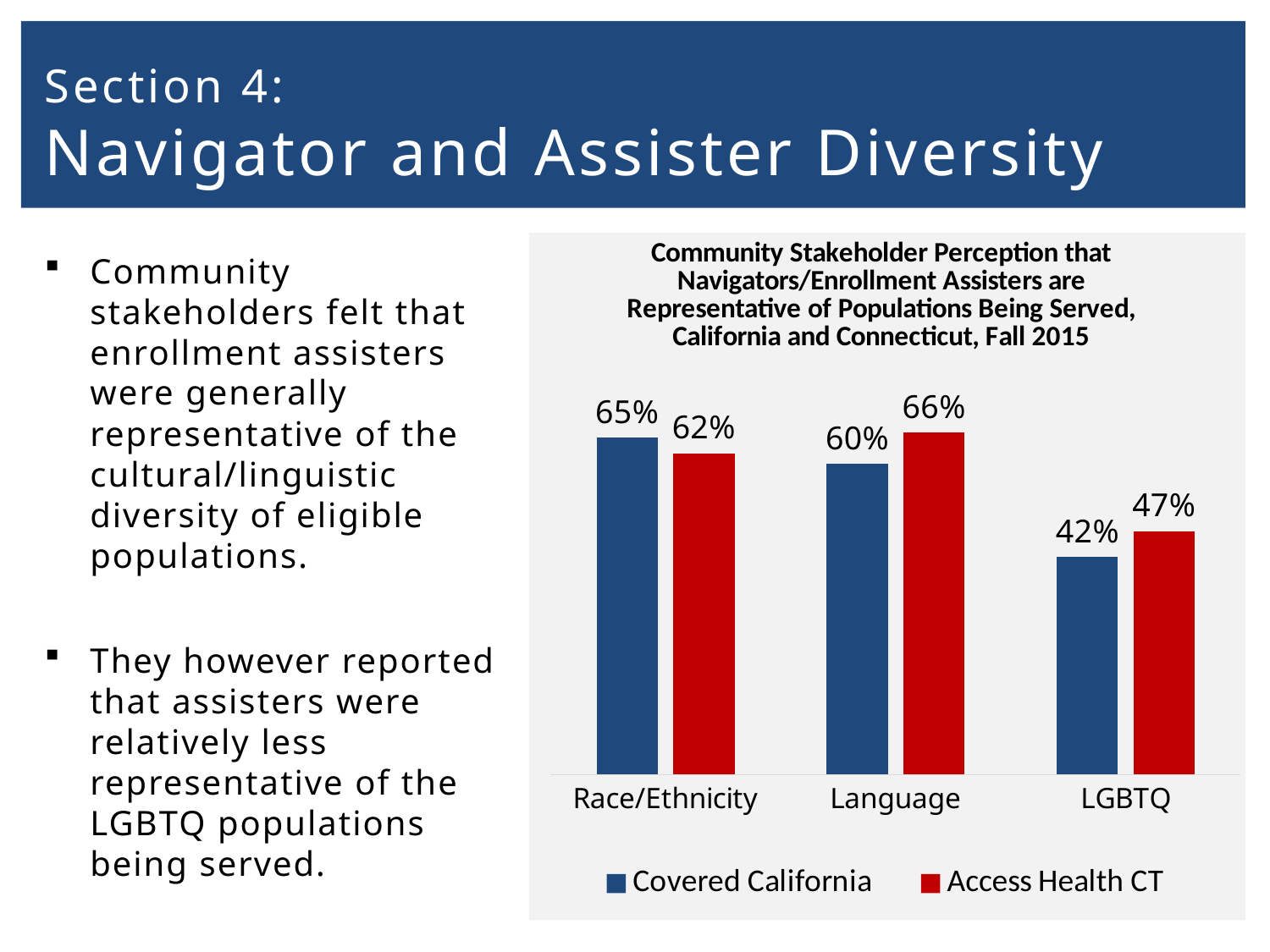
What is the difference between the Access Health CT and Covered California values for LGBTQ? 5% What is the difference between the Covered California and Access Health CT values for Race/Ethnicity? 3% What is the value for Access Health CT in the LGBTQ category? 47% What is the value for Covered California in the LGBTQ category? 42% Which category has the highest value for Access Health CT? Language What is the value for Access Health CT in the Language category? 66% Which is larger in the Language category, Covered California or Access Health CT? Access Health CT What kind of chart is shown on the slide? Bar chart Which category has the lowest value for Covered California? LGBTQ How many categories are shown on the x axis? 3 How many series does the legend list? 2 What is the value for Covered California in the Race/Ethnicity category? 65%